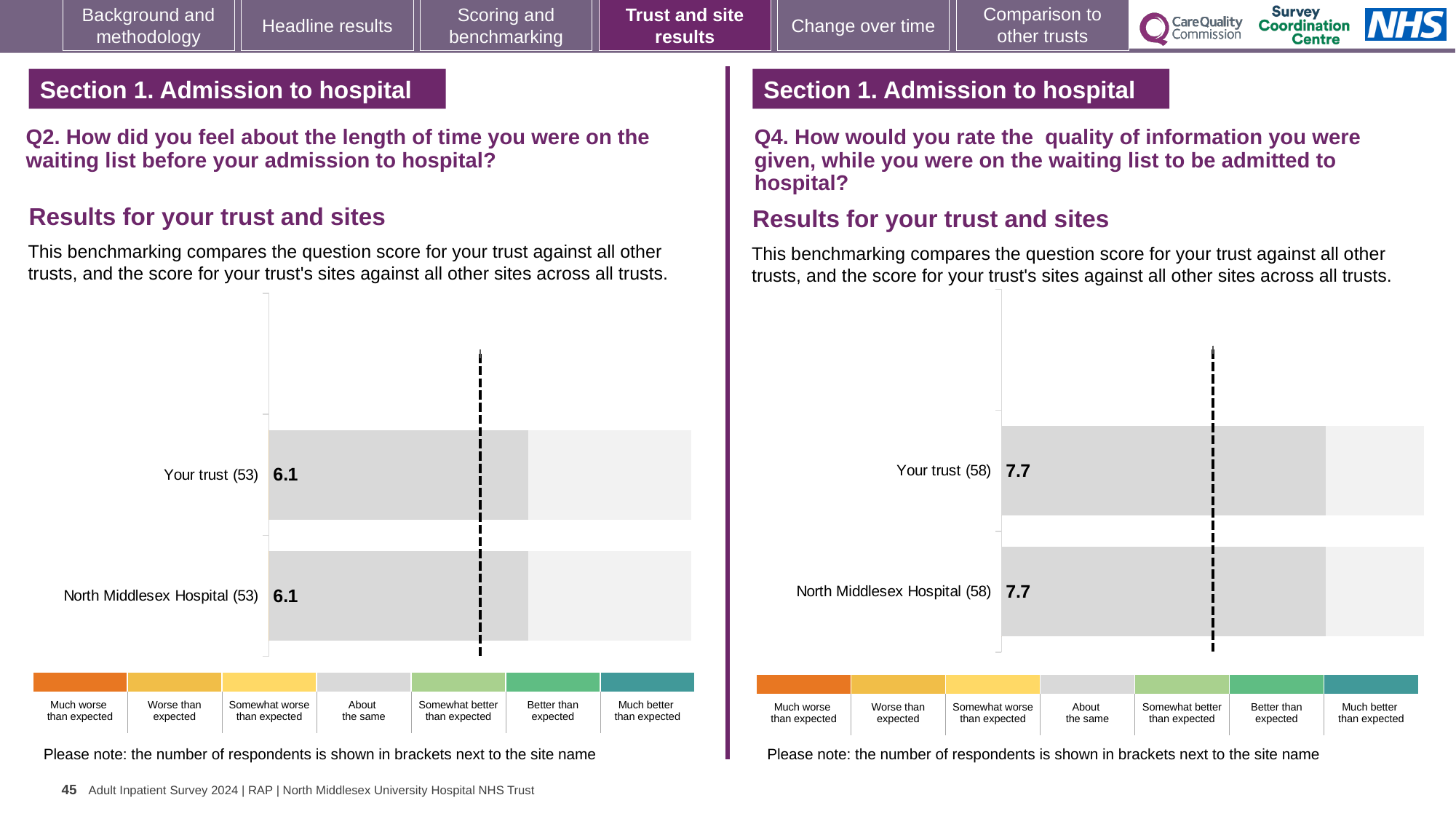
On the Q2 chart (left), what is the score for North Middlesex Hospital? 6.1 On the Q4 chart (right), how many bars are plotted? 2 On the Q4 chart (right), what is the difference between the score for Your trust and the score for North Middlesex Hospital? 0.0 On the Q2 chart (left), what is the score for Your trust? 6.1 What kind of chart is the Q2 chart (left)? Bar chart On the Q2 chart (left), how many respondents are shown in brackets for Your trust? 53 On the Q4 chart (right), what is the score for North Middlesex Hospital? 7.7 On the Q4 chart (right), how many respondents are shown in brackets for North Middlesex Hospital? 58 On the Q4 chart (right), what is the score for Your trust? 7.7 On the Q2 chart (left), how many bars are plotted? 2 On the Q4 chart (right), which benchmark category does the colour of the bars correspond to in the legend? About the same On the Q2 chart (left), what is the difference between the score for Your trust and the score for North Middlesex Hospital? 0.0